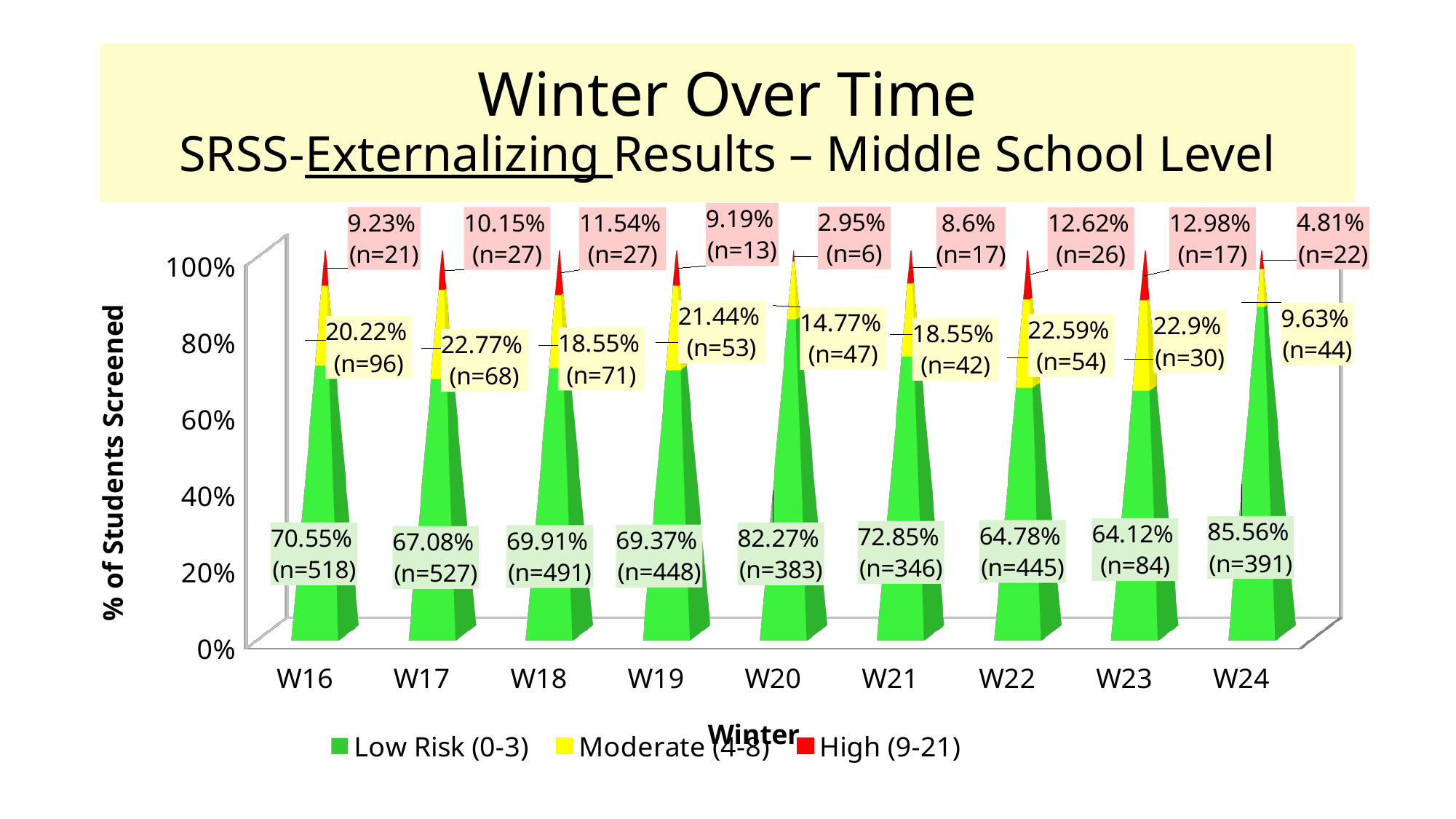
Which winter has the lowest High (9-21) percentage? W20 What is the Low Risk (0-3) percentage for W16? 70.55% How many students were in the Low Risk (0-3) group for W23 (the n value)? n=84 What is the High (9-21) percentage for W20? 2.95% What is the Moderate (4-8) percentage for W19? 21.44% What is the difference in Low Risk (0-3) percentage between W24 and W16? 15.01 percentage points How many winters are shown on the x axis? 9 Which winter has the highest High (9-21) percentage? W23 Which winter has the highest Low Risk (0-3) percentage? W24 Which has a larger Low Risk (0-3) percentage, W20 or W21? W20 What kind of chart is shown on the slide? Stacked bar chart How many series does the legend list? 3